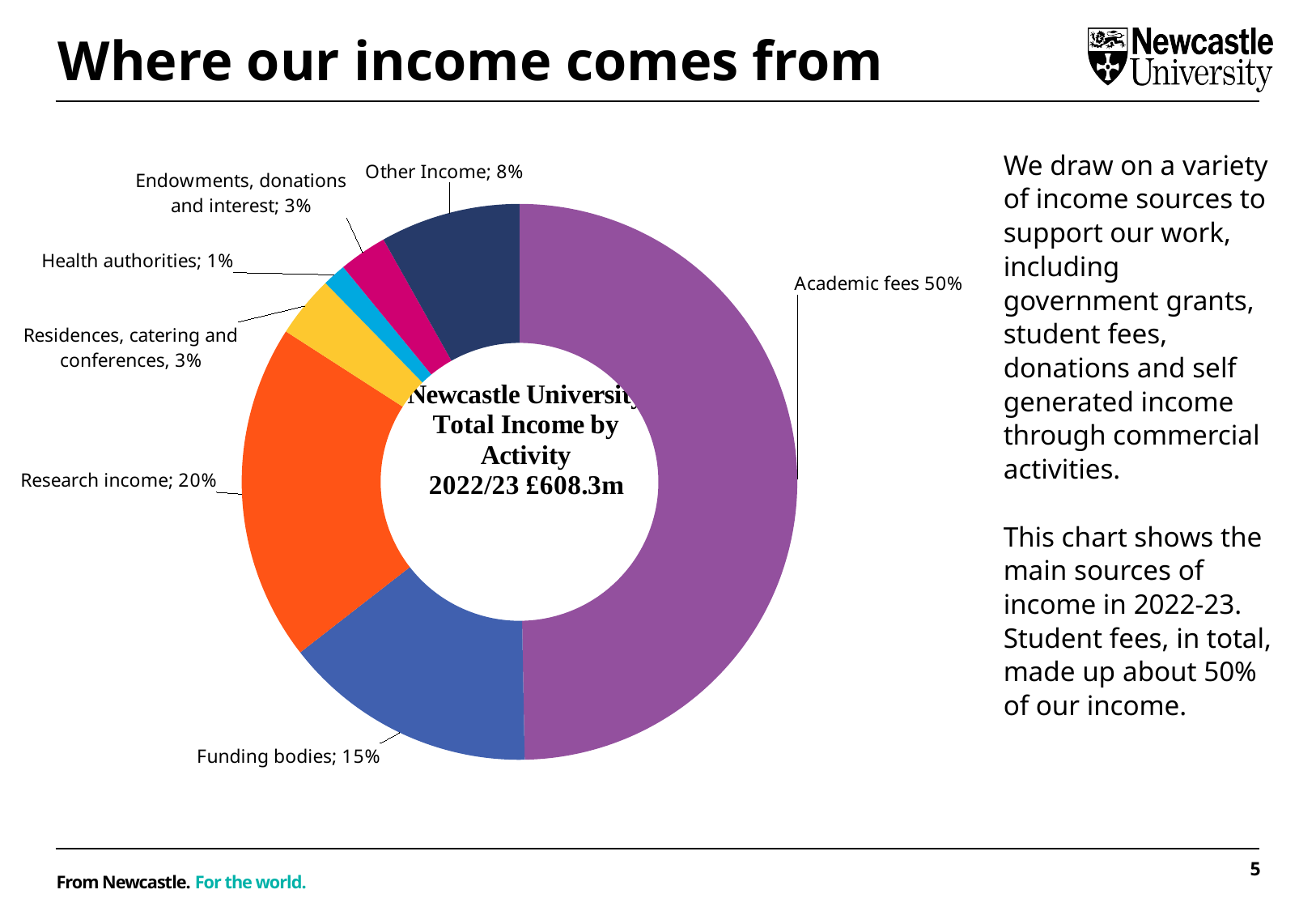
Which is larger, the share for Other Income or the share for Endowments, donations and interest? Other Income What is the difference in percentage points between Research income and Funding bodies? 5 What kind of chart is shown on the slide? Pie chart (doughnut) Which income source has the largest share? Academic fees What share of income comes from Research income? 20% What share of income comes from Health authorities? 1% What share of income comes from Funding bodies? 15% Which income source has the smallest share? Health authorities What total income figure is shown in the centre of the chart? £608.3m What share of income comes from Other Income? 8% What share of income comes from Academic fees? 50% How many income categories are shown in the chart? 7